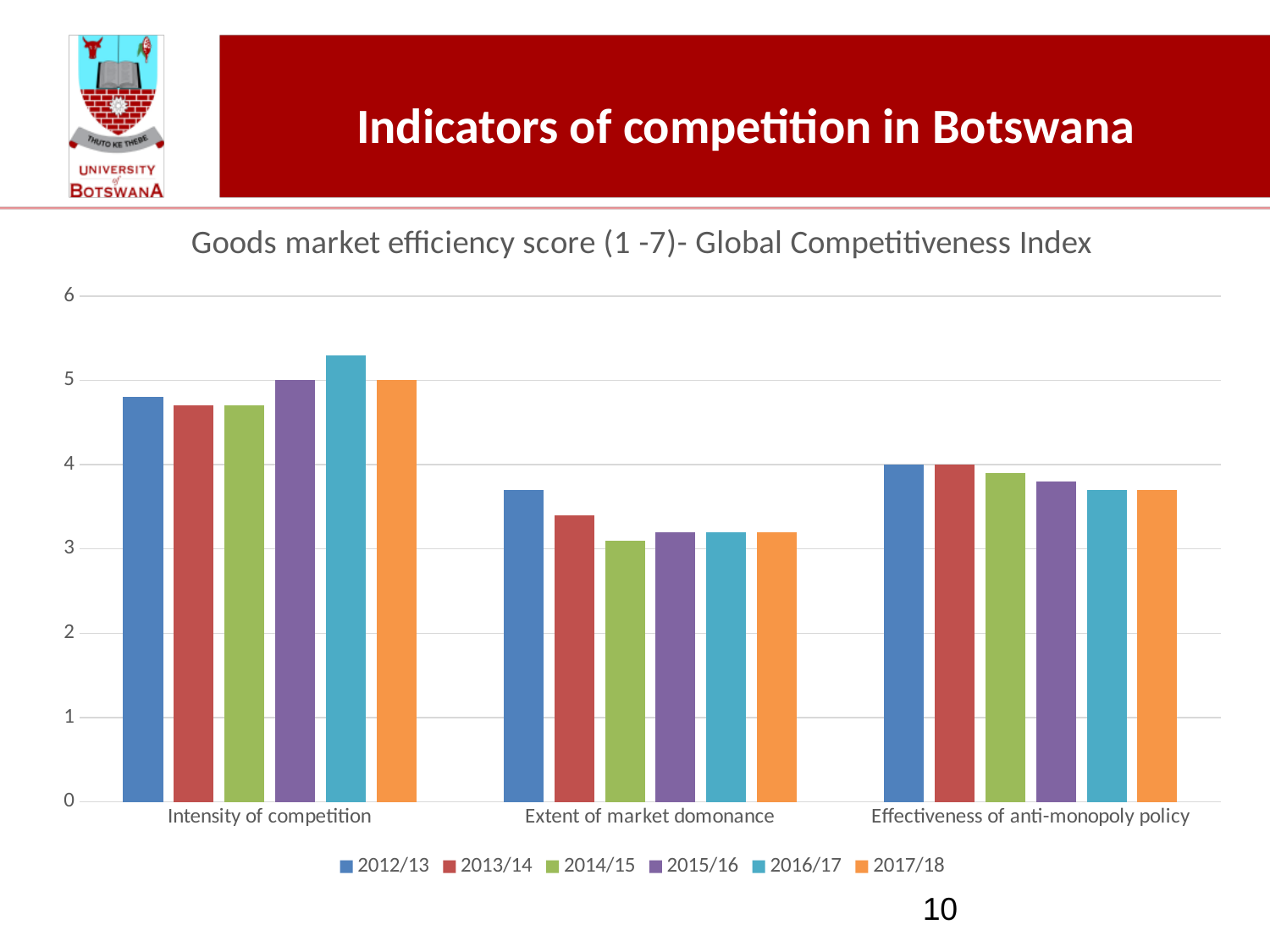
Which category has the highest scores overall in the chart? Intensity of competition Is the 2016/17 value for Intensity of competition greater or less than 5? greater Is the 2016/17 value for Effectiveness of anti-monopoly policy greater or less than 4? less For Effectiveness of anti-monopoly policy, do the scores rise or fall from 2012/13 to 2017/18? fall Which category has the lowest scores overall in the chart? Extent of market domonance How many categories are shown on the x axis of the chart? 3 For Extent of market domonance, which is larger: the 2012/13 value or the 2013/14 value? 2012/13 What kind of chart is shown on the slide? bar chart Is the 2012/13 value for Extent of market domonance greater or less than 4? less How many series does the chart's legend list? 6 What is the title of the chart? Goods market efficiency score (1 -7)- Global Competitiveness Index Within the Intensity of competition category, which year has the highest score? 2016/17